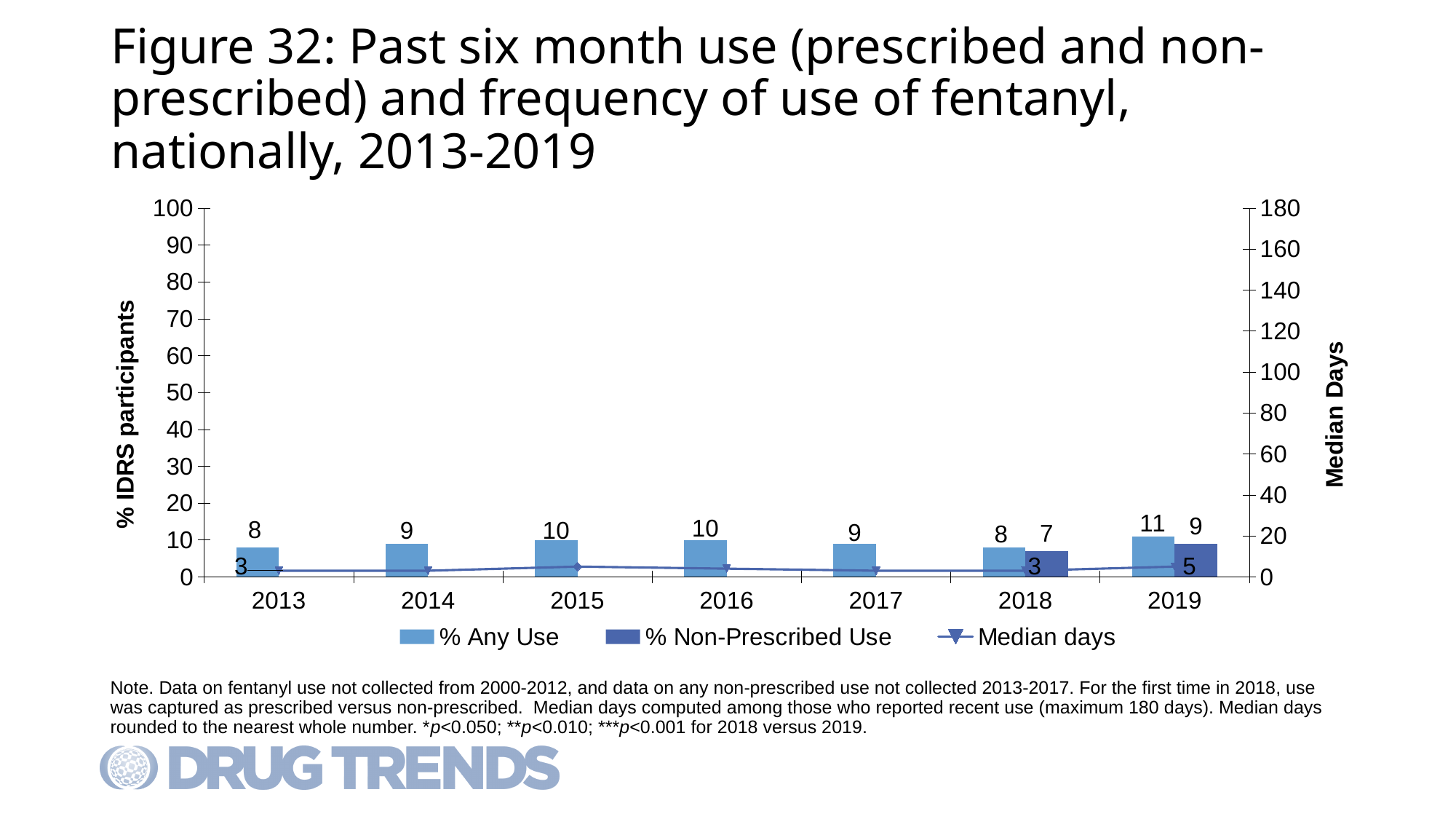
Is the % Any Use value for 2016 greater or less than 20? less Which year has the highest % Any Use value? 2019 What is the % Any Use value for 2019? 11 What is the Median days value for 2019? 5 How many years are shown on the x axis? 7 What is the difference in % Any Use between 2019 and 2018? 3 What is the % Any Use value for 2015? 10 What is the difference between the % Any Use and % Non-Prescribed Use values in 2019? 2 Which is larger, the % Non-Prescribed Use value in 2018 or in 2019? 2019 How many series does the legend list? 3 What is the % Non-Prescribed Use value for 2018? 7 What is the label of the right-hand vertical axis? Median Days